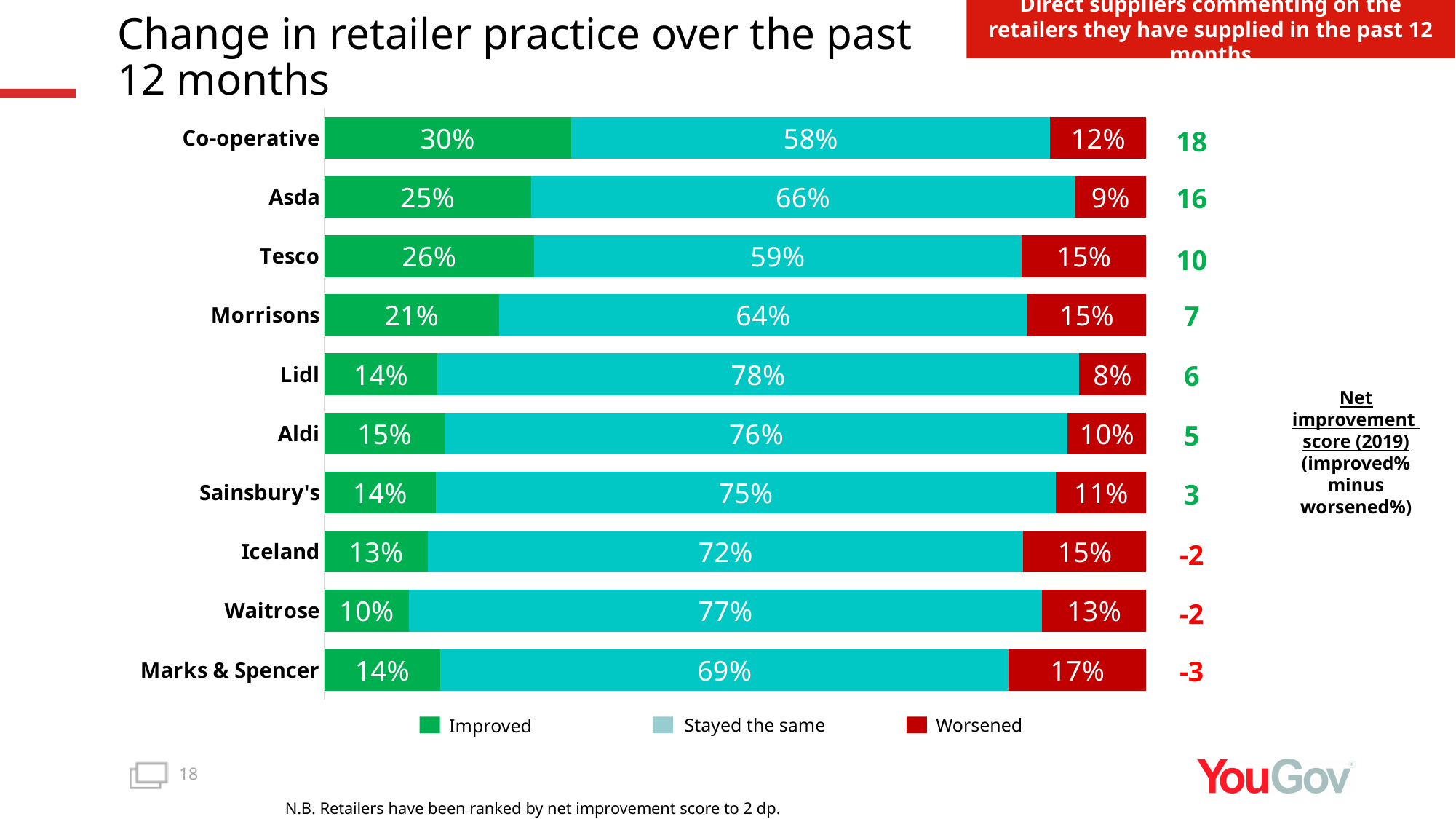
Which retailer has the highest 'Improved' percentage? Co-operative What is the net improvement score shown for Iceland? -2 How many retailers are shown in the chart? 10 Which is larger: Tesco's 'Improved' percentage or Morrisons' 'Improved' percentage? Tesco What kind of chart is shown on the slide? Stacked bar chart Which retailer has the highest 'Worsened' percentage? Marks & Spencer Which retailer has the lowest 'Improved' percentage? Waitrose What percentage of suppliers said Co-operative's practice improved? 30% What percentage of suppliers said Marks & Spencer's practice worsened? 17% What is the difference between Asda's 'Stayed the same' percentage and Co-operative's 'Stayed the same' percentage? 8% What percentage of suppliers said Lidl's practice stayed the same? 78% How many series does the legend list? 3